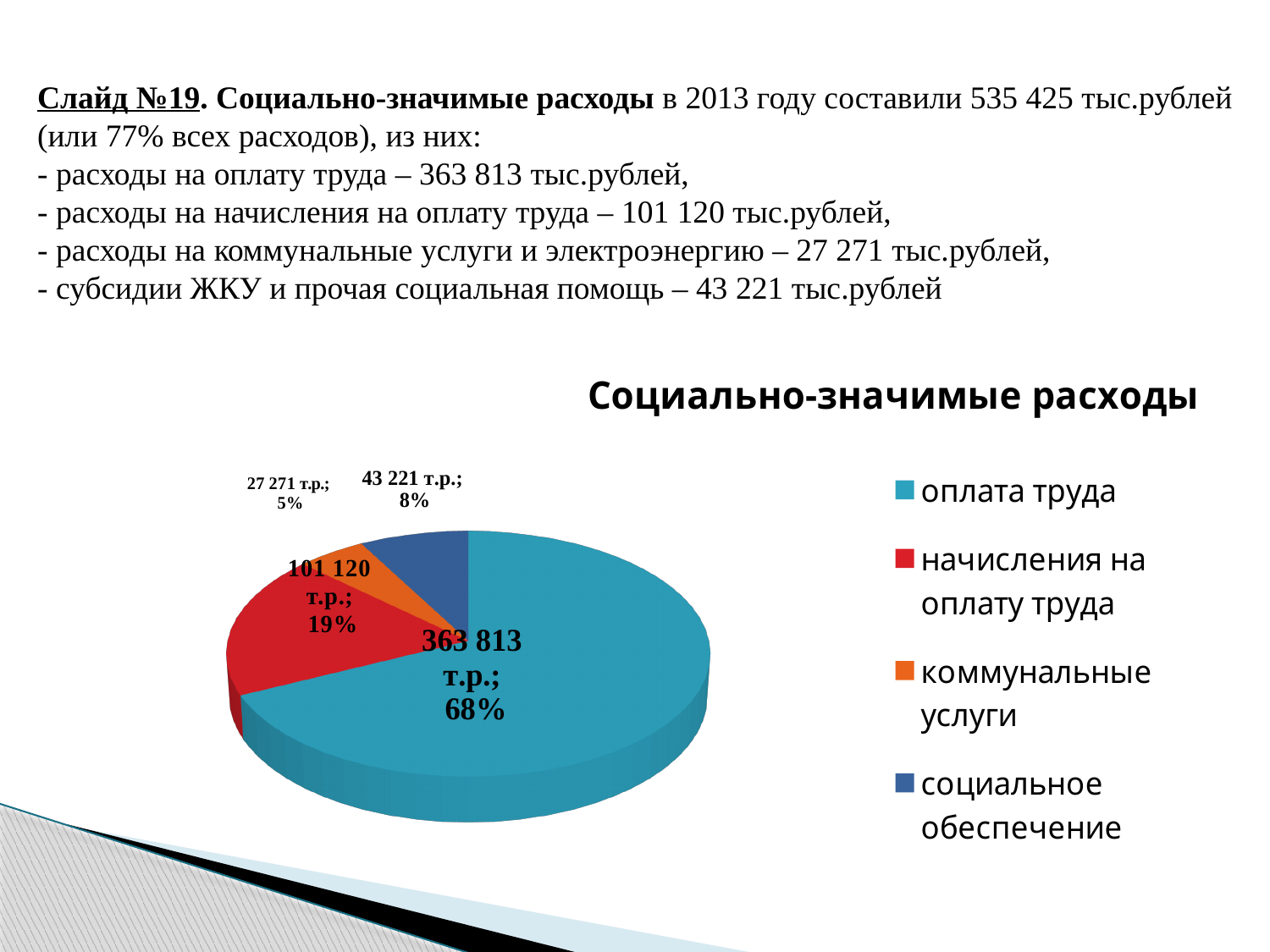
Which is larger: социальное обеспечение or коммунальные услуги? социальное обеспечение What is the value for социальное обеспечение in the pie chart? 43 221 т.р. How many categories does the legend of the pie chart list? 4 Which category has the largest slice in the pie chart? оплата труда What share of the pie does оплата труда take? 68% What share of the pie does начисления на оплату труда take? 19% What kind of chart is shown on the slide? pie chart What is the value for начисления на оплату труда in the pie chart? 101 120 т.р. What is the value for оплата труда in the pie chart? 363 813 т.р. What is the value for коммунальные услуги in the pie chart? 27 271 т.р. Which category has the smallest slice in the pie chart? коммунальные услуги What is the difference between the values for оплата труда and начисления на оплату труда? 262 693 т.р.